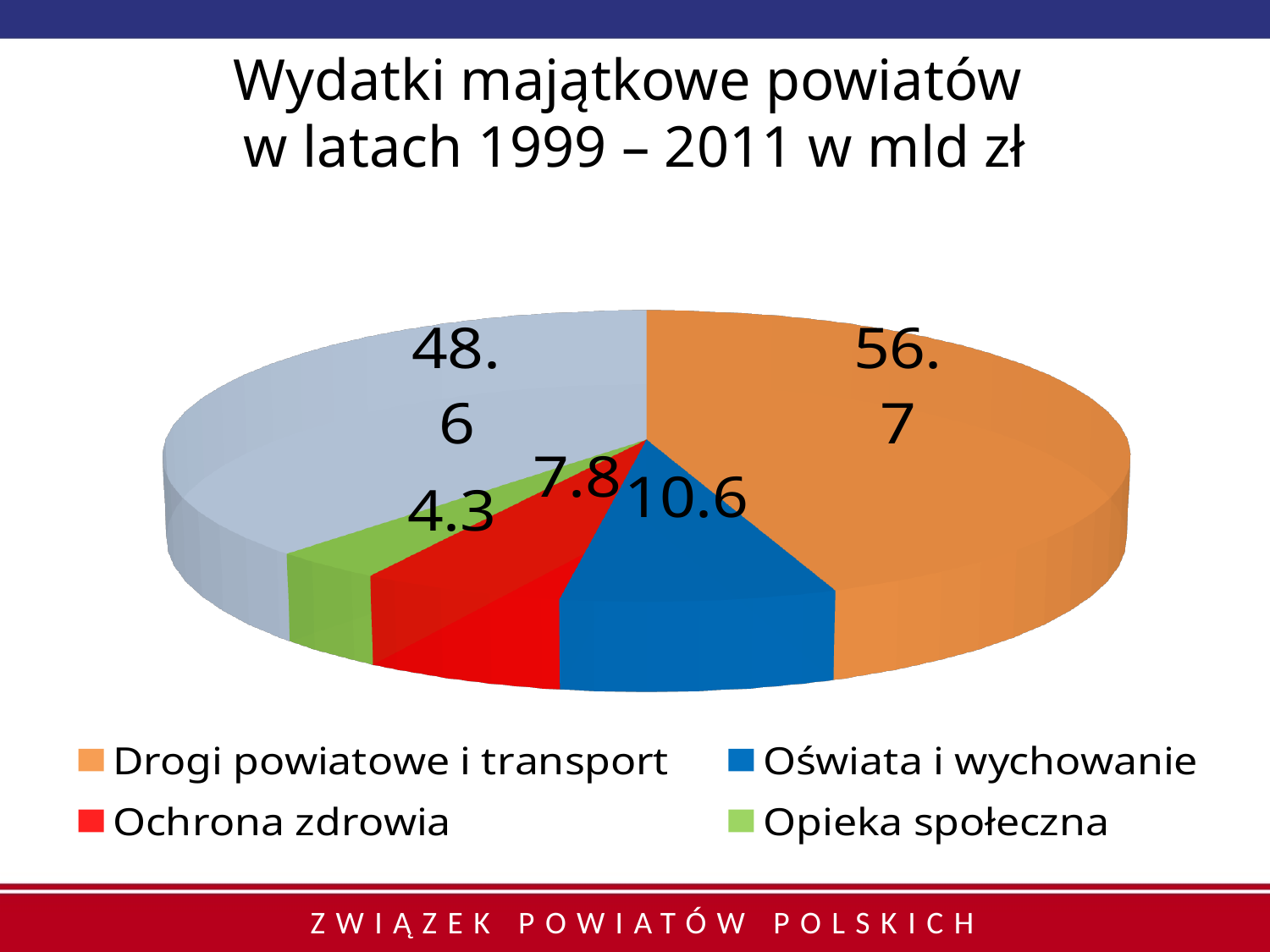
Which is larger, the value for Ochrona zdrowia or the value for Opieka społeczna? Ochrona zdrowia How many slices does the pie chart have? 5 What is the value for Drogi powiatowe i transport? 56.7 Which legend category has the smallest slice? Opieka społeczna What is the value for Ochrona zdrowia? 7.8 What is the difference between the values for Drogi powiatowe i transport and Oświata i wychowanie? 46.1 What type of chart is shown on the slide? pie chart What is the value for Opieka społeczna? 4.3 What is the value for Oświata i wychowanie? 10.6 What is the difference between the values for Oświata i wychowanie and Ochrona zdrowia? 2.8 How many entries does the legend list? 4 Which legend category has the largest slice? Drogi powiatowe i transport